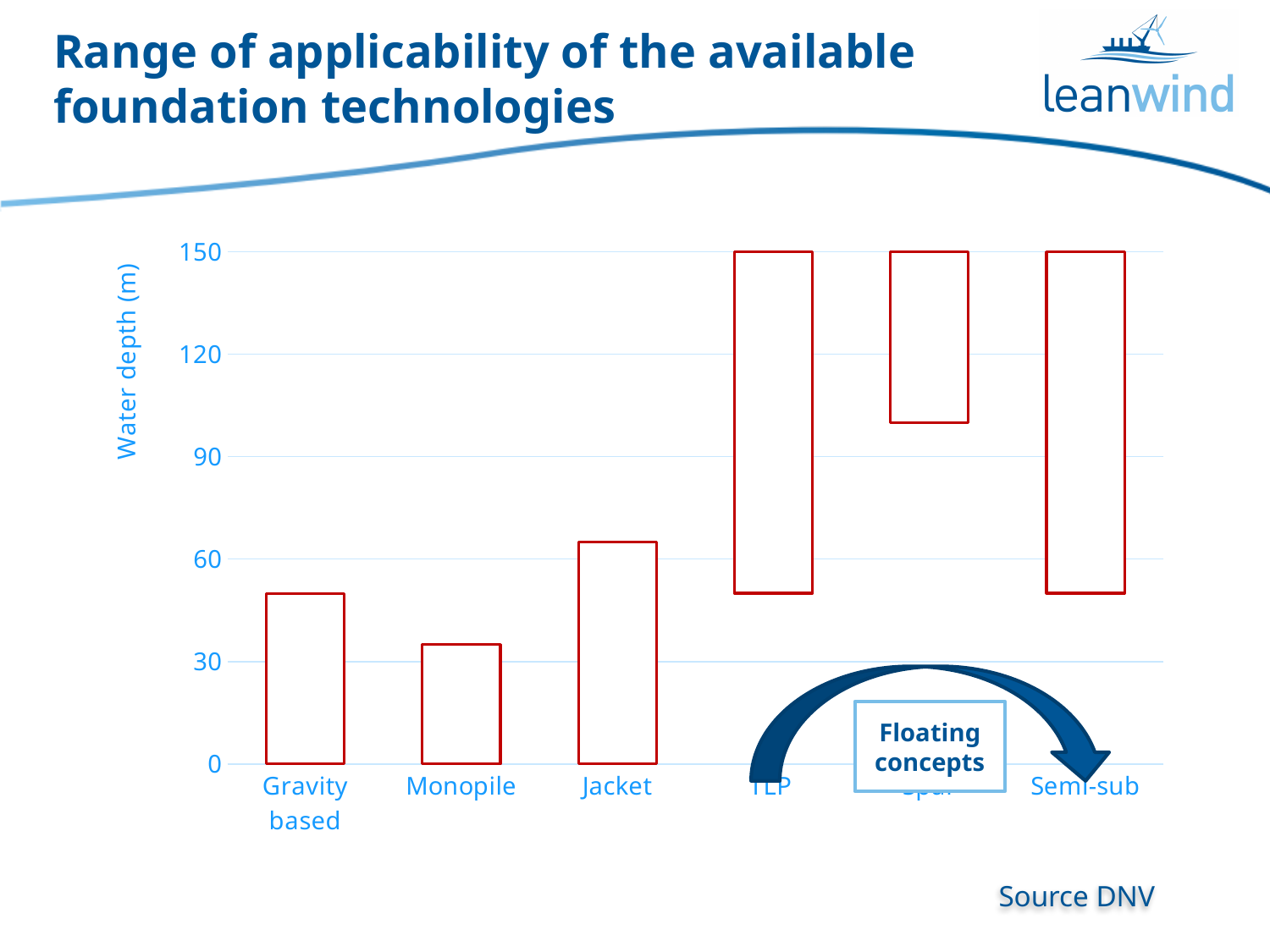
What kind of chart is shown on the slide? bar chart Is the maximum water depth for Gravity based greater or less than 60? less What is the minimum water depth shown for Monopile? 0 What is the maximum water depth shown for Semi-sub? 150 Which has the higher maximum water depth, Jacket or Gravity based? Jacket Which has the higher minimum water depth, Spar or TLP? Spar What is the label of the vertical axis of the chart? Water depth (m) What is the maximum water depth shown for TLP? 150 Is the maximum water depth for Jacket greater or less than 60? greater Which foundation technology has the lowest maximum water depth? Monopile Is the minimum water depth for Spar greater or less than 90? greater How many foundation technologies are shown on the x axis of the chart? 6